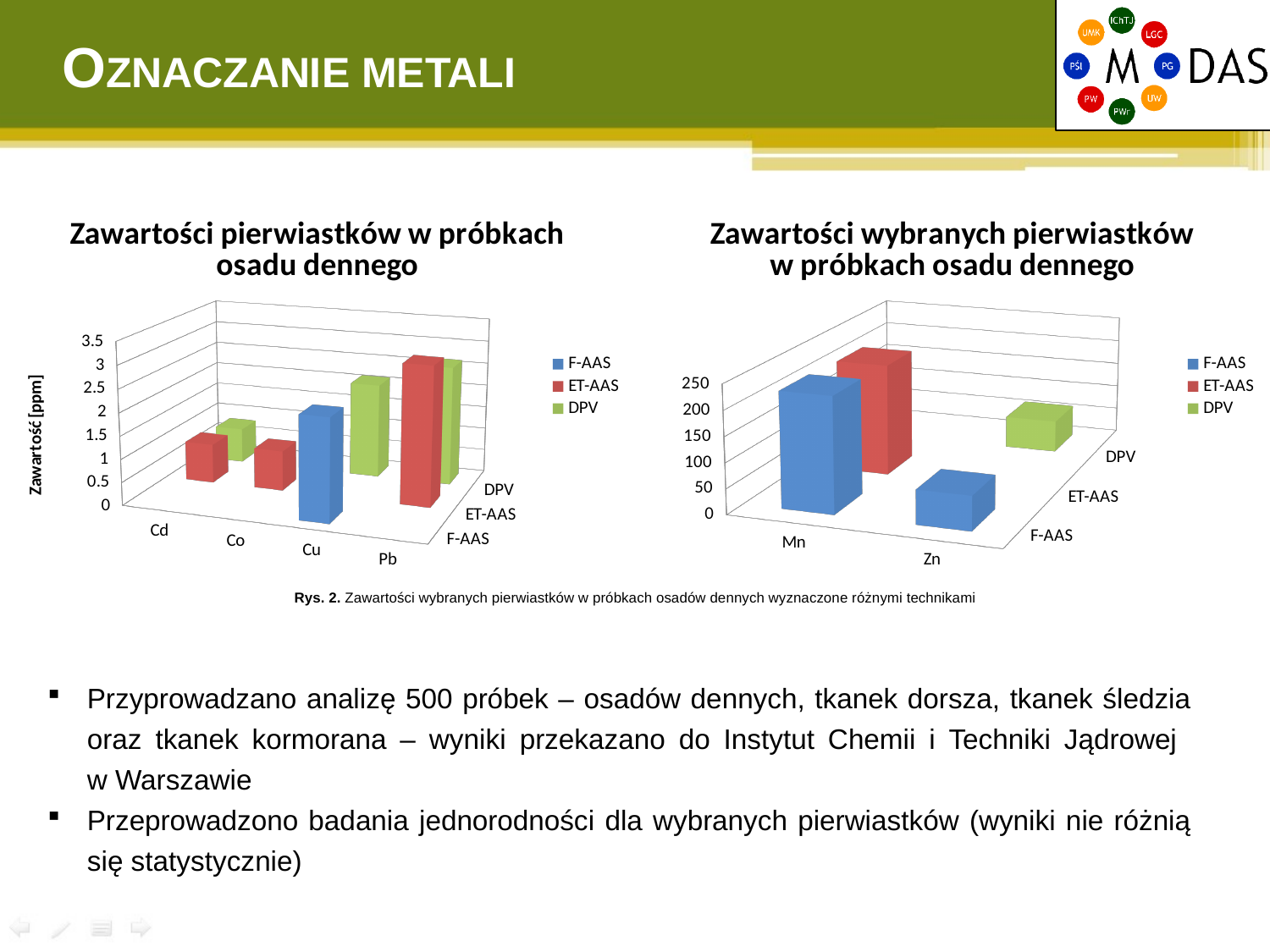
How many element categories are shown on the x axis of the left chart? 4 In the right chart, is the F-AAS value for Zn greater or less than 150? less In the left chart, is the ET-AAS value for Pb greater or less than 2? greater In the left chart, which is larger: the ET-AAS value for Pb or the ET-AAS value for Cd? Pb How many series does the legend of the left chart list? 3 In the right chart, is the F-AAS value for Mn greater or less than 100? greater How many element categories are shown on the x axis of the right chart, 'Zawartości wybranych pierwiastków w próbkach osadu dennego'? 2 What kind of chart is the left chart, 'Zawartości pierwiastków w próbkach osadu dennego'? bar chart What is the label of the vertical axis of the left chart? Zawartość [ppm]